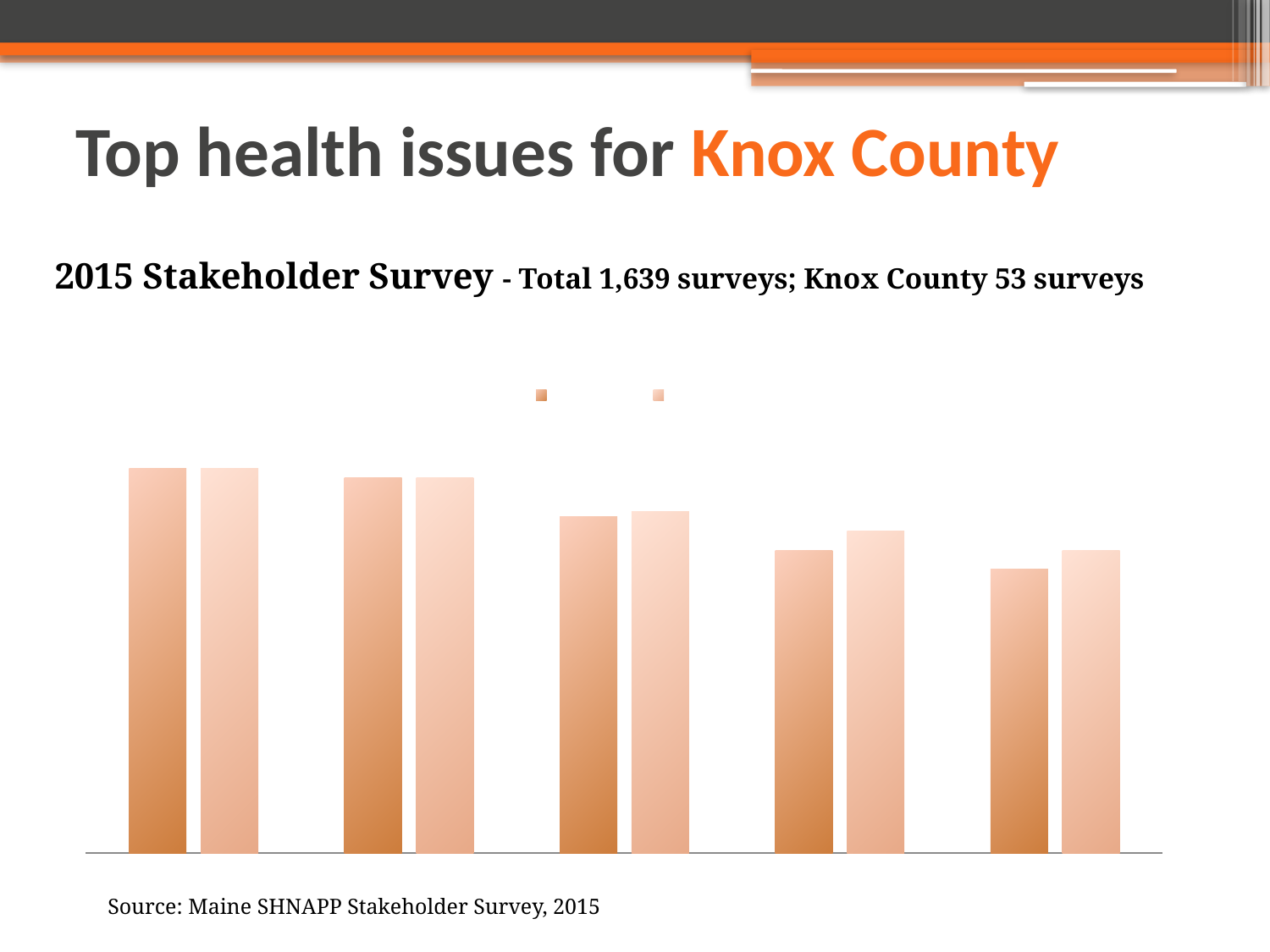
Which group of bars, counting from the left, has the tallest bars in the chart? the first group According to the slide, how many surveys were completed for Knox County? 53 surveys What source is cited below the chart? Maine SHNAPP Stakeholder Survey, 2015 What kind of chart is shown on the slide? bar chart Do the bar heights generally rise or fall moving from left to right across the chart? fall How many series does the chart's legend show? 2 Which group of bars, counting from the left, has the shortest bars in the chart? the fifth group How many groups of bars (categories) are plotted in the chart? 5 In the fourth group of bars from the left, is the darker orange bar or the lighter orange bar taller? the lighter orange bar In the rightmost group of bars, is the darker orange bar or the lighter orange bar taller? the lighter orange bar